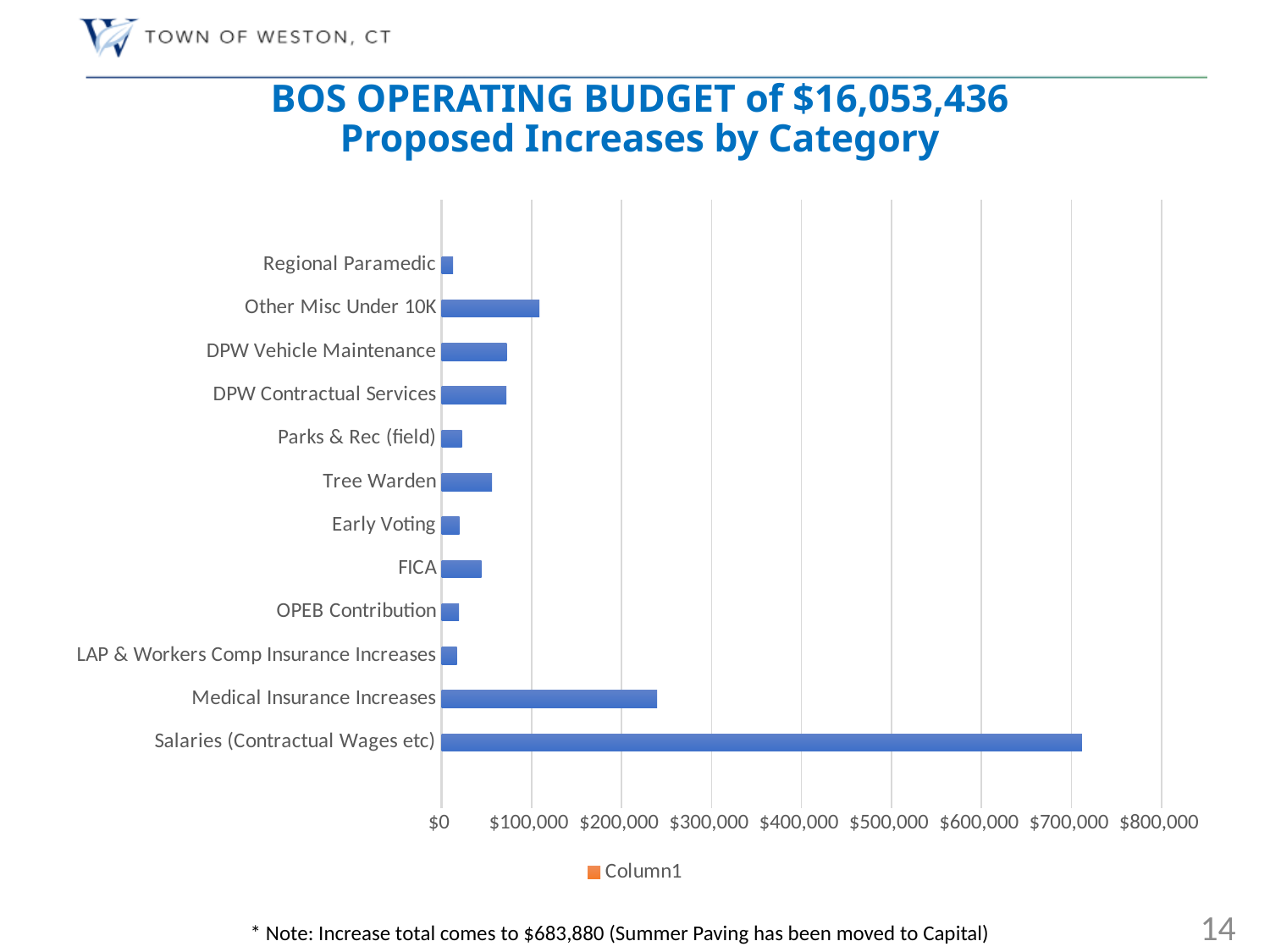
Which category has the largest proposed increase? Salaries (Contractual Wages etc) What is the name of the series shown in the chart legend? Column1 Which category has the smallest proposed increase? Regional Paramedic What kind of chart is shown on the slide? bar chart Which is larger, the value for Medical Insurance Increases or the value for Other Misc Under 10K? Medical Insurance Increases Is the value for Tree Warden greater or less than $100,000? less How many categories are plotted in the chart? 12 Is the value for DPW Vehicle Maintenance greater or less than $100,000? less Is the value for Salaries (Contractual Wages etc) greater or less than $600,000? greater How many series does the legend list? 1 Which is larger, the value for Tree Warden or the value for FICA? Tree Warden